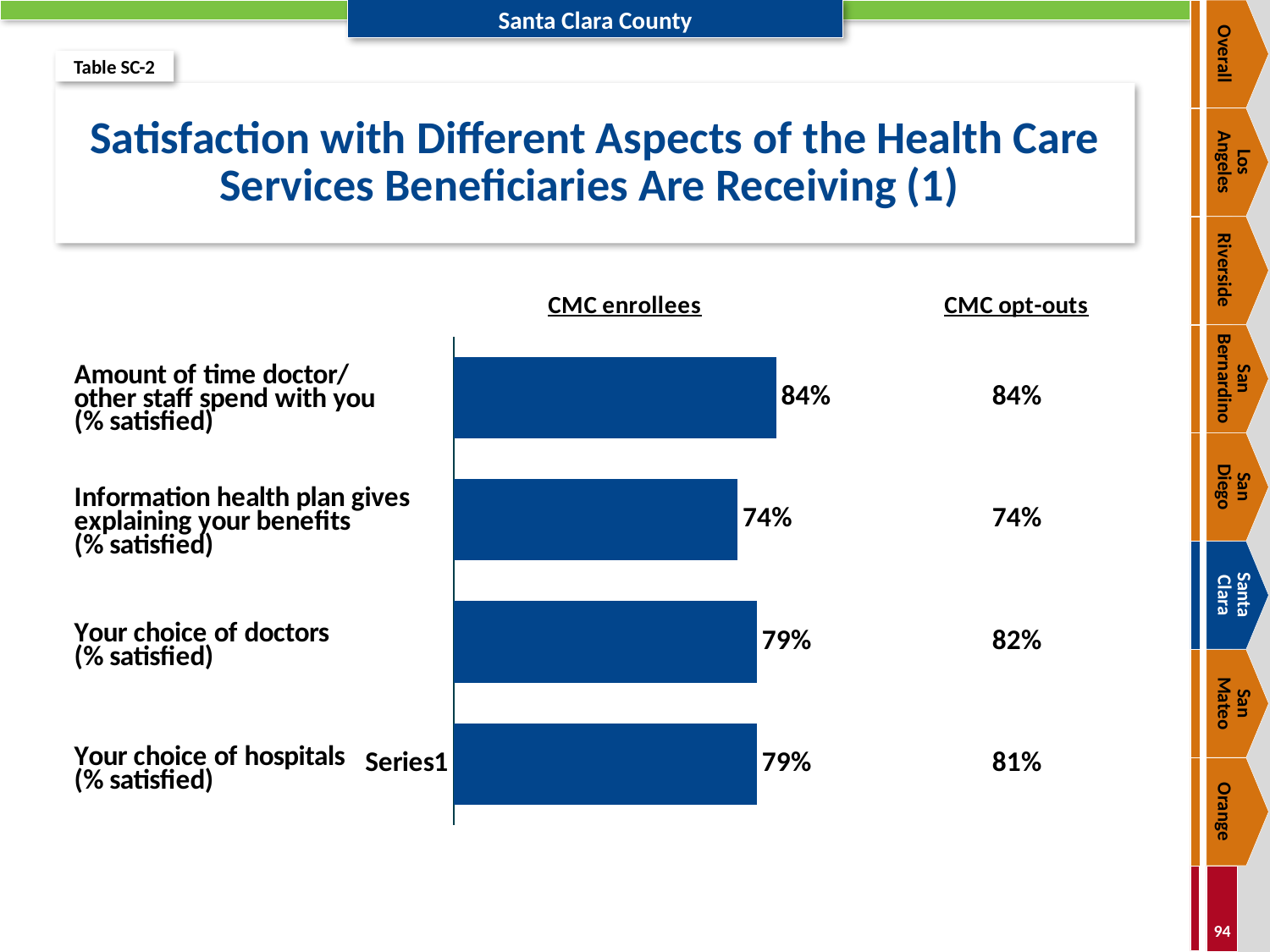
Which is larger for CMC enrollees: 'Your choice of doctors' or 'Information health plan gives explaining your benefits'? Your choice of doctors What is the CMC enrollees value for 'Information health plan gives explaining your benefits (% satisfied)'? 74% What series label is printed next to the bottom bar of the chart? Series1 What is the CMC enrollees value for 'Your choice of doctors (% satisfied)'? 79% What kind of chart is shown on the slide? Bar chart What is the CMC enrollees value for 'Your choice of hospitals (% satisfied)'? 79% How many categories are plotted in the bar chart? 4 What is the difference between the CMC enrollees values for 'Amount of time doctor/other staff spend with you' and 'Information health plan gives explaining your benefits'? 10% Which category has the lowest CMC enrollees bar? Information health plan gives explaining your benefits (% satisfied) What is the difference between the CMC opt-outs and CMC enrollees values for 'Your choice of doctors (% satisfied)'? 3% What is the CMC enrollees value for 'Amount of time doctor/other staff spend with you (% satisfied)'? 84% Which category has the highest CMC enrollees bar? Amount of time doctor/other staff spend with you (% satisfied)